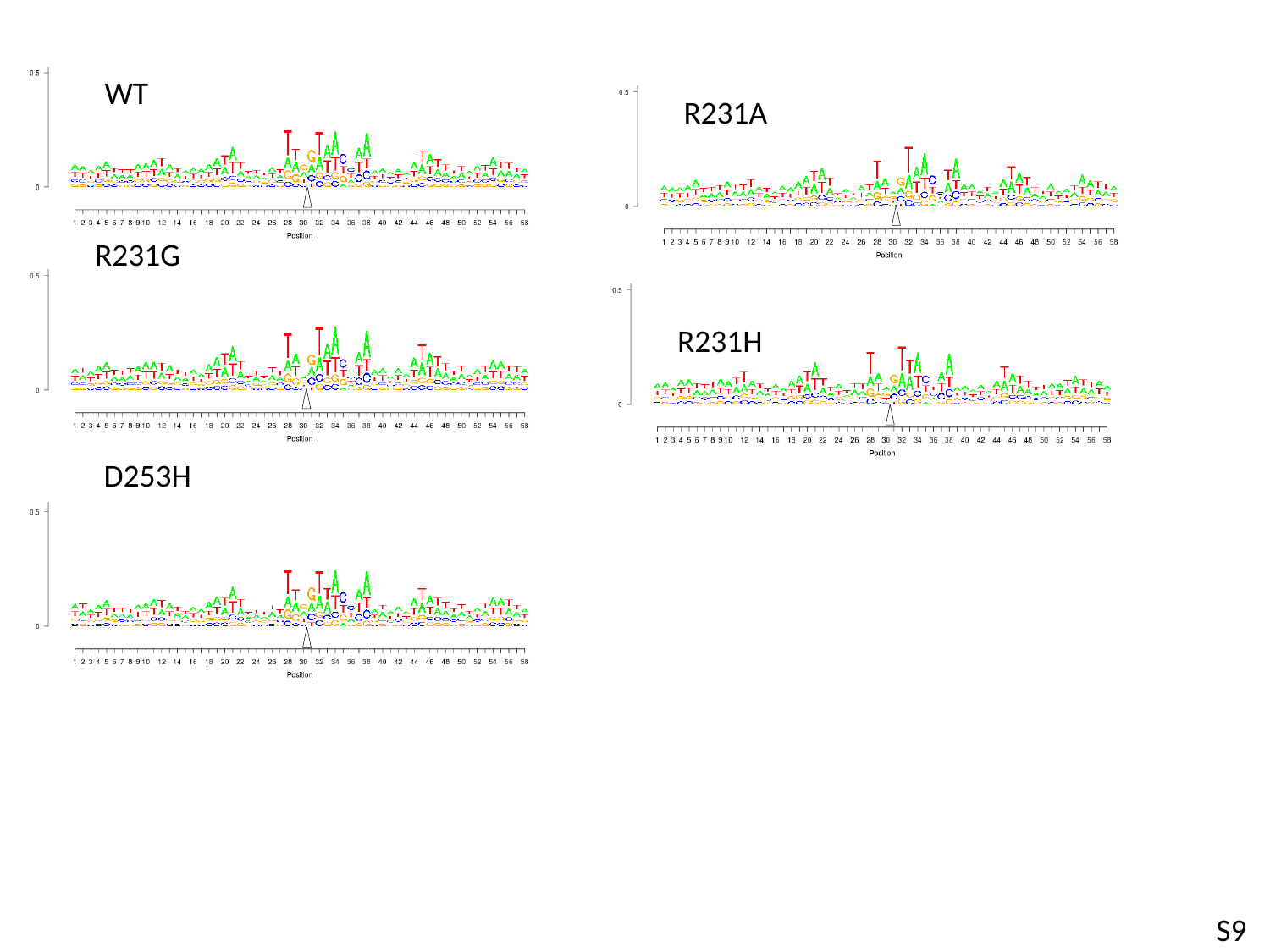
In the D253H chart, is the value at position 1 greater or less than 0.5? less In the WT chart, is the value at position 31 greater or less than 0.5? less Which chart is positioned at the bottom left of the slide? D253H What is the highest tick value shown on the y axis of the R231A chart? 0.5 How many sequence logo charts are shown on the slide? 5 What is the last position number shown on the x axis of the R231A chart? 58 What is the label of the x axis on the D253H chart? Position What is the first position number shown on the x axis of the R231H chart? 1 In the R231G chart, is the value at position 38 greater or less than 0.5? less